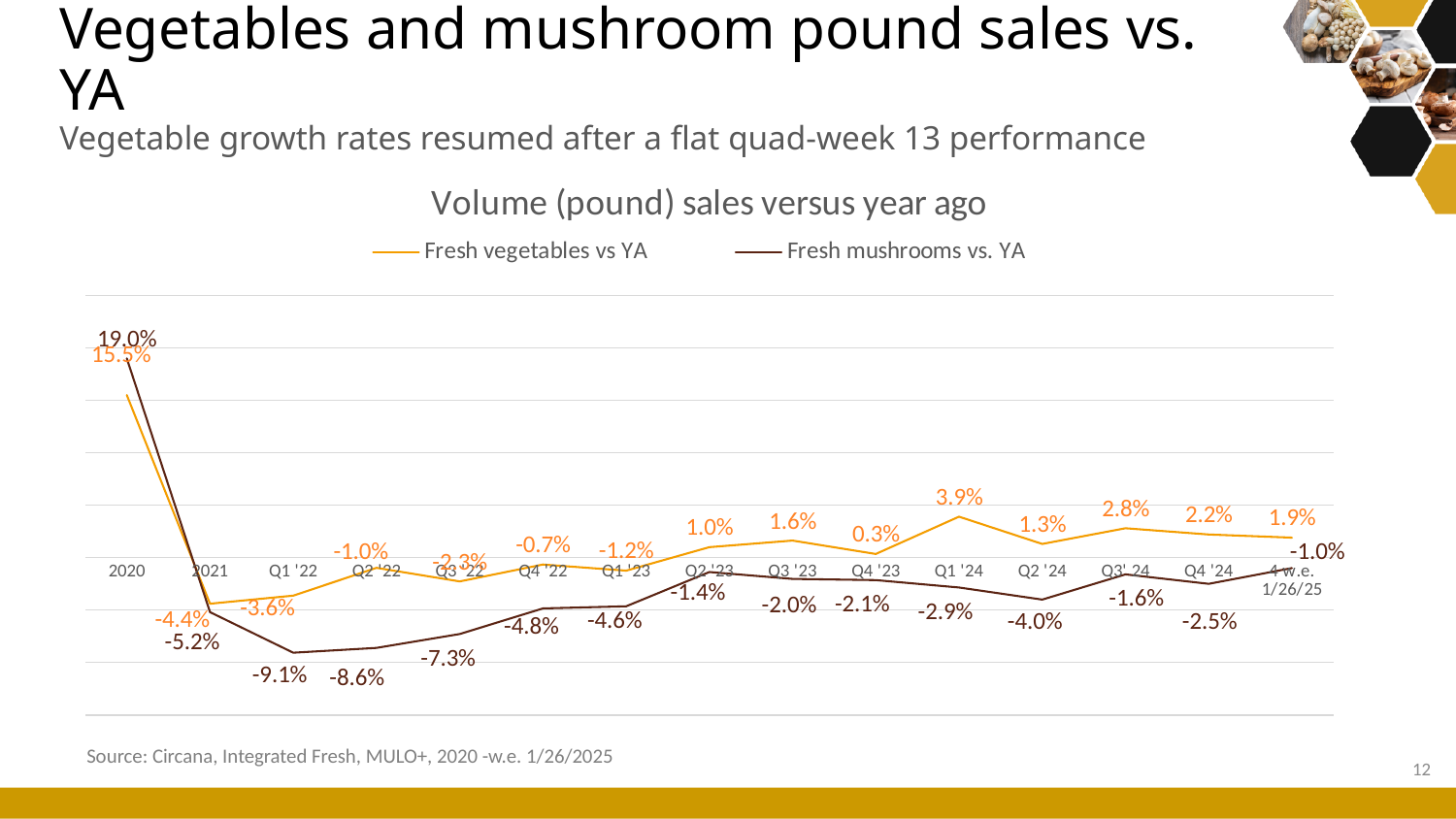
What is the value for Fresh mushrooms vs. YA for the 4 w.e. 1/26/25 period? -1.0% How many series does the legend list? 2 What is the value for Fresh vegetables vs YA in 2020? 15.5% What is the value for Fresh mushrooms vs. YA in Q1 '22? -9.1% What is the difference between Fresh vegetables vs YA and Fresh mushrooms vs. YA in Q2 '24? 5.3 percentage points What is the title of the chart? Volume (pound) sales versus year ago Which period has the lowest value for Fresh vegetables vs YA? 2021 In Q3 '24, which series has the larger value, Fresh vegetables vs YA or Fresh mushrooms vs. YA? Fresh vegetables vs YA Which period has the lowest value for Fresh mushrooms vs. YA? Q1 '22 What is the value for Fresh vegetables vs YA in Q1 '24? 3.9% What type of chart is shown on the slide? Line chart Which period has the highest value for Fresh mushrooms vs. YA? 2020